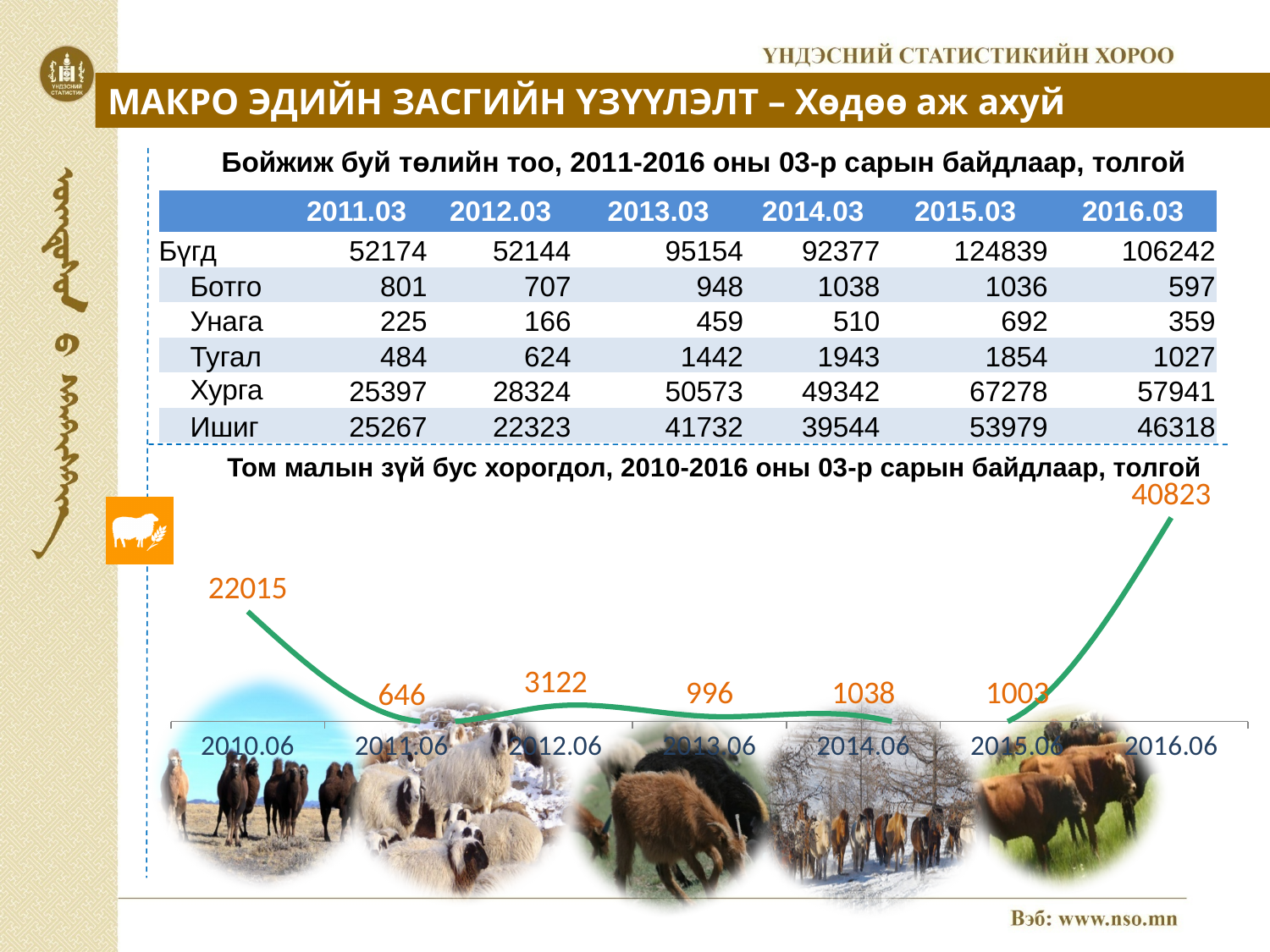
In the line chart 'Том малын зүй бус хорогдол', which is larger, the value for 2012.06 or the value for 2013.06? 2012.06 In the line chart 'Том малын зүй бус хорогдол', what is the value for 2016.06? 40823 In the line chart 'Том малын зүй бус хорогдол', what is the value for 2010.06? 22015 In the line chart 'Том малын зүй бус хорогдол', which year has the highest value? 2016.06 How many data points are plotted in the line chart 'Том малын зүй бус хорогдол'? 7 What kind of chart is shown at the bottom of the slide under the title 'Том малын зүй бус хорогдол'? line chart In the line chart 'Том малын зүй бус хорогдол', what is the value for 2012.06? 3122 In the line chart 'Том малын зүй бус хорогдол', what is the value for 2014.06? 1038 What is the title of the line chart at the bottom of the slide? Том малын зүй бус хорогдол, 2010-2016 оны 03-р сарын байдлаар, толгой In the line chart 'Том малын зүй бус хорогдол', what is the difference between the values for 2016.06 and 2010.06? 18808 In the line chart 'Том малын зүй бус хорогдол', does the value rise or fall from 2015.06 to 2016.06? rise In the line chart 'Том малын зүй бус хорогдол', which year has the lowest value? 2011.06